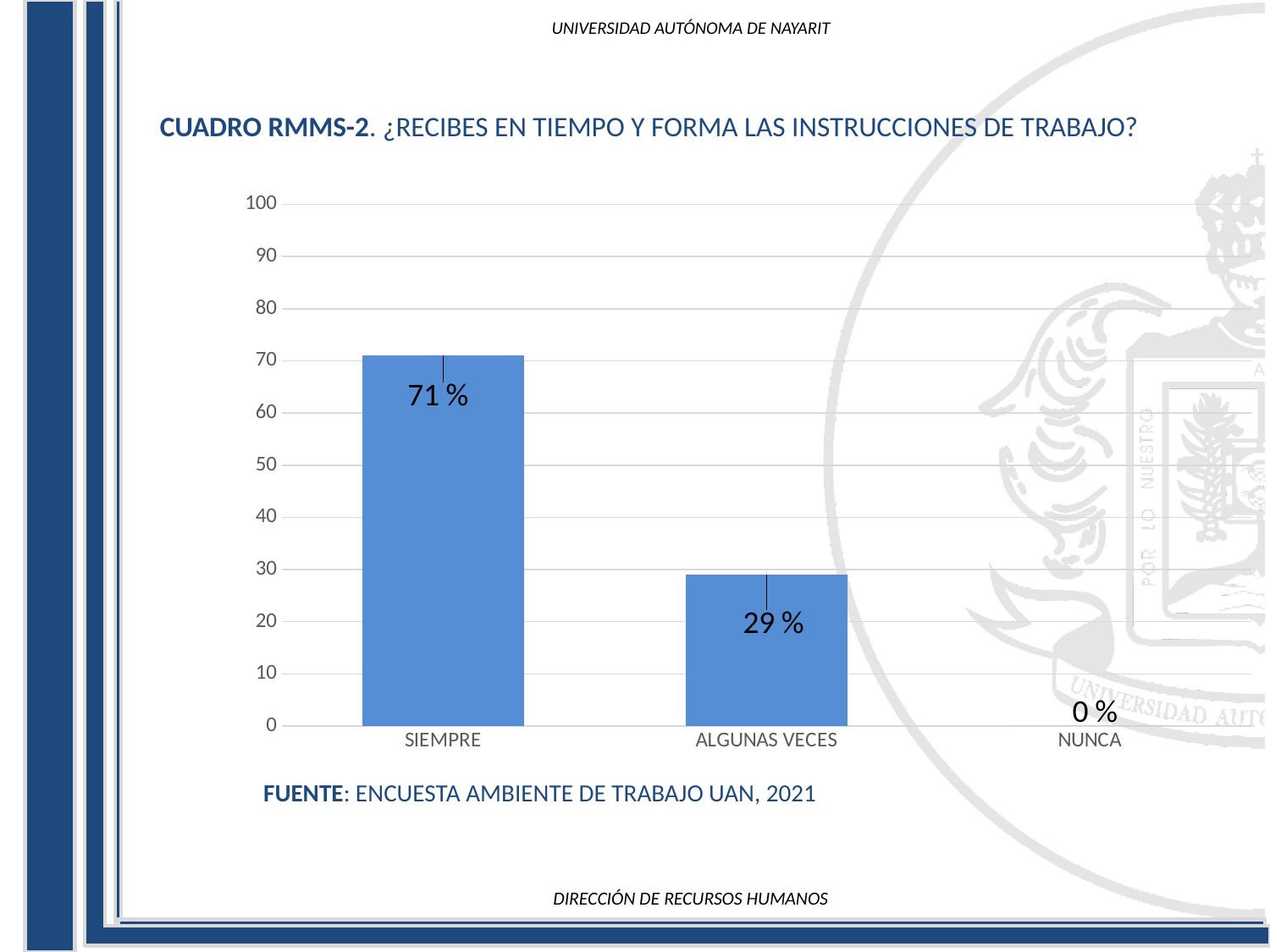
What is the difference between the values for SIEMPRE and ALGUNAS VECES? 42 % How many categories are shown on the x axis? 3 What is the value for SIEMPRE? 71 % Is the value for ALGUNAS VECES greater or less than 40? less Is the value for SIEMPRE greater or less than 60? greater What kind of chart is shown on the slide? bar chart What is the source cited below the chart? ENCUESTA AMBIENTE DE TRABAJO UAN, 2021 Which is larger, the value for SIEMPRE or the value for ALGUNAS VECES? SIEMPRE Which category has the highest value? SIEMPRE What is the value for NUNCA? 0 % What is the value for ALGUNAS VECES? 29 % Which category has the lowest value? NUNCA